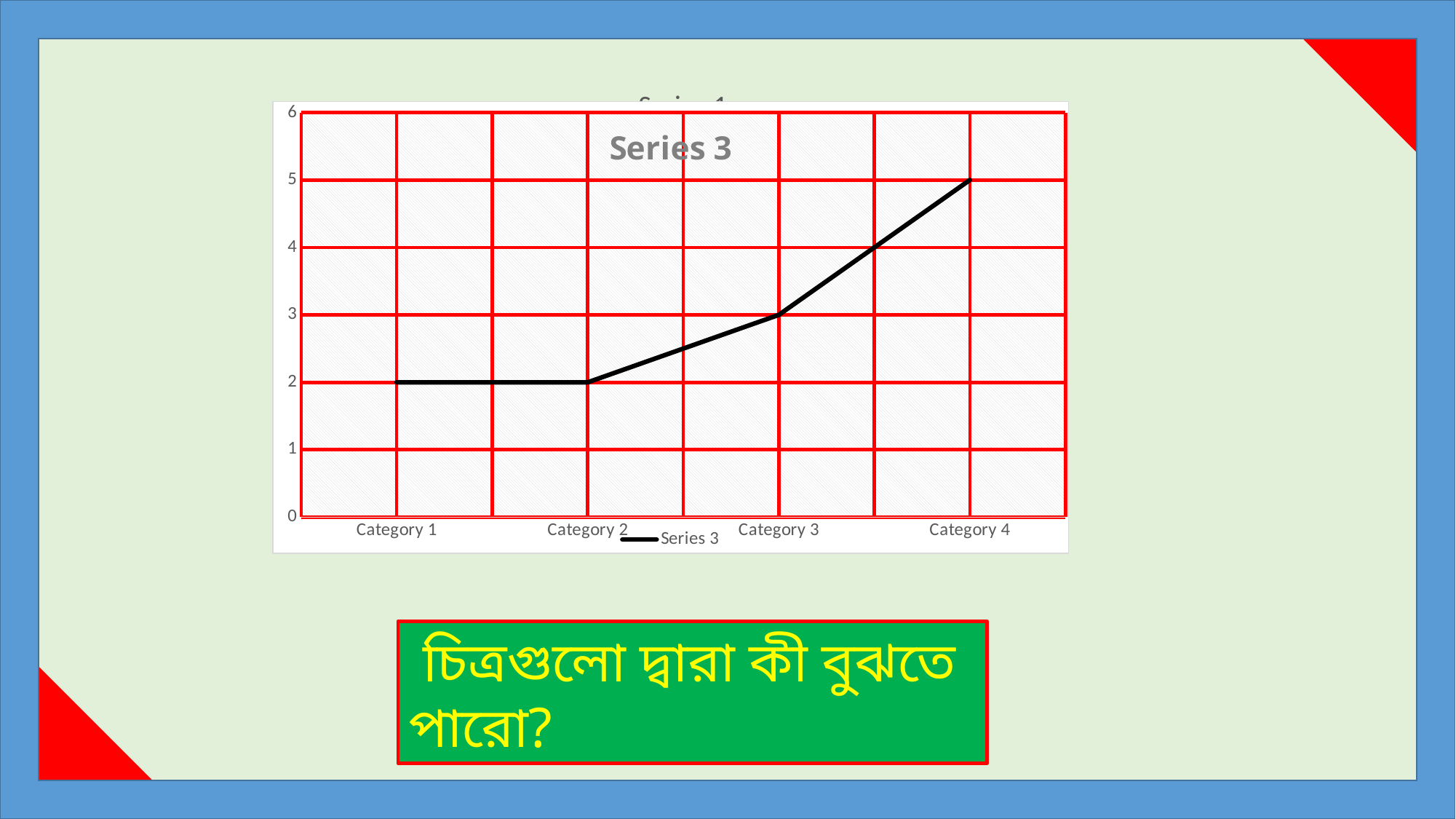
What is the difference between the Series 3 values for Category 4 and Category 2? 3 What is the value of Series 3 for Category 4? 5 What is the value of Series 3 for Category 3? 3 What is the title shown on the chart? Series 3 What kind of chart is shown on the slide? line chart How many series does the legend list? 1 What is the value of Series 3 for Category 1? 2 How many categories are shown on the x axis? 4 Which category has the highest value for Series 3? Category 4 Which is larger, the Series 3 value for Category 3 or for Category 1? Category 3 Do the values rise or fall from Category 2 to Category 4? rise Is the value for Category 4 greater or less than 4? greater